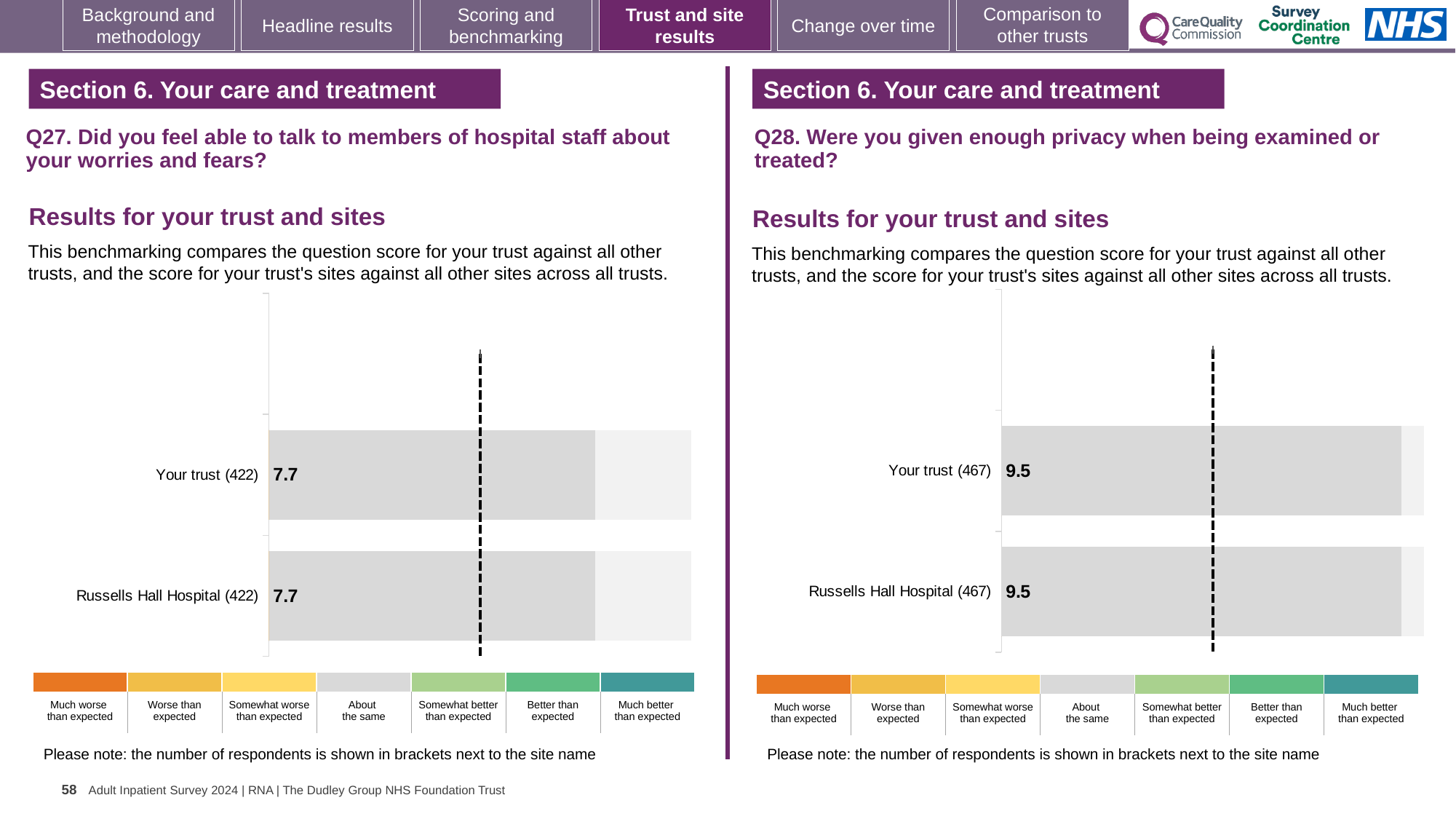
On the Q27 chart (left), what is the difference between the score for Your trust and the score for Russells Hall Hospital? 0 What kind of chart is the Q28 chart (right)? Bar chart On the Q28 chart (right), what is the score for Russells Hall Hospital? 9.5 On the Q28 chart (right), how many respondents are shown in brackets for Russells Hall Hospital? 467 On the Q27 chart (left), how many respondents are shown in brackets for Your trust? 422 Is the score for Your trust on the Q28 chart (right) larger or smaller than the score for Your trust on the Q27 chart (left)? Larger On the Q27 chart (left), what is the score for Your trust? 7.7 On the Q28 chart (right), what is the score for Your trust? 9.5 How many bars are plotted on the Q27 chart (left)? 2 On the Q27 chart (left), what is the score for Russells Hall Hospital? 7.7 On the Q28 chart (right), what is the difference between the score for Your trust and the score for Russells Hall Hospital? 0 How many bars are plotted on the Q28 chart (right)? 2